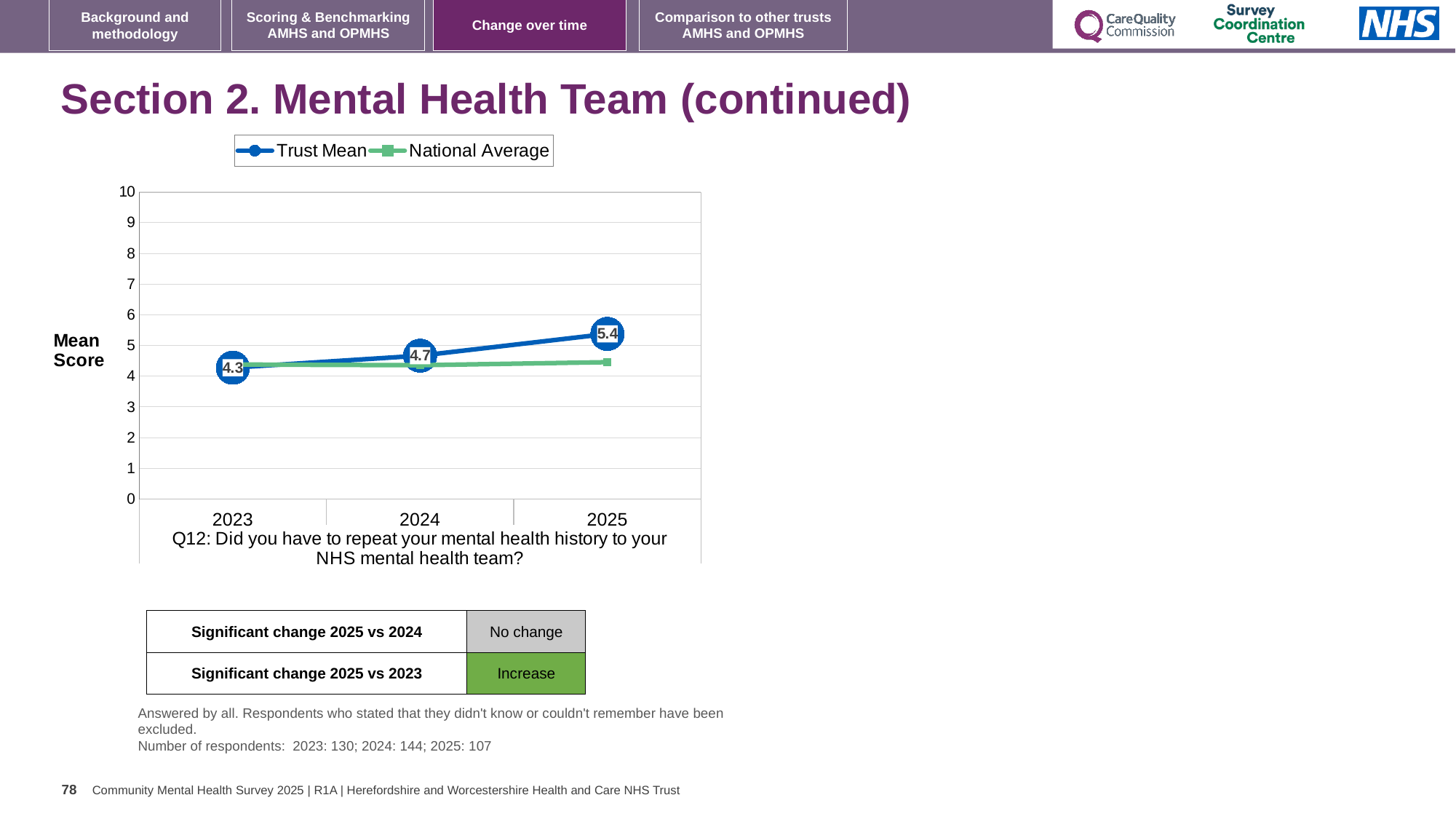
In which year is the Trust Mean highest? 2025 In which year is the Trust Mean lowest? 2023 What is the difference between the Trust Mean in 2025 and in 2023? 1.1 What kind of chart is shown on the slide? Line chart What is the Trust Mean score for 2023? 4.3 Does the Trust Mean rise or fall from 2023 to 2025? Rise What is the Trust Mean score for 2024? 4.7 What is the Trust Mean score for 2025? 5.4 How many series does the legend list? 2 In 2025, which is larger: the Trust Mean or the National Average? Trust Mean Is the National Average value for 2025 greater or less than 5? less How many years are plotted on the x axis? 3